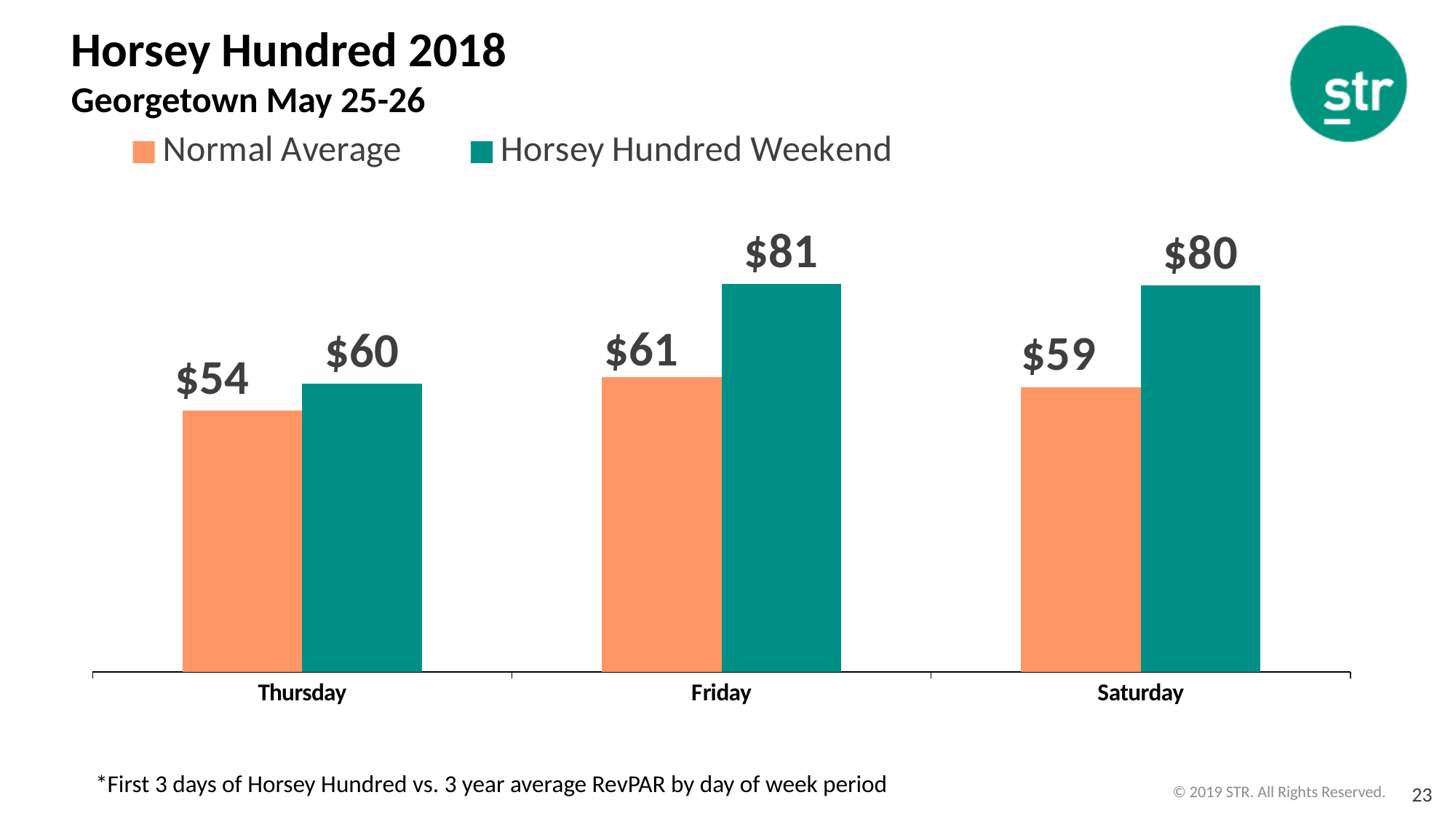
What is the difference between the Horsey Hundred Weekend and Normal Average values for Saturday? $21 Which colour represents the Horsey Hundred Weekend series? Teal (green) Which day has the lowest Normal Average value? Thursday What is the Horsey Hundred Weekend value for Friday? $81 What kind of chart is shown on the slide? Bar chart How many days are shown on the x axis? 3 What is the Normal Average value for Saturday? $59 How many series does the legend list? 2 What is the difference between the Horsey Hundred Weekend and Normal Average values for Friday? $20 Which day has the highest Horsey Hundred Weekend value? Friday What is the Normal Average value for Thursday? $54 Which is larger on Thursday, the Normal Average or the Horsey Hundred Weekend value? Horsey Hundred Weekend